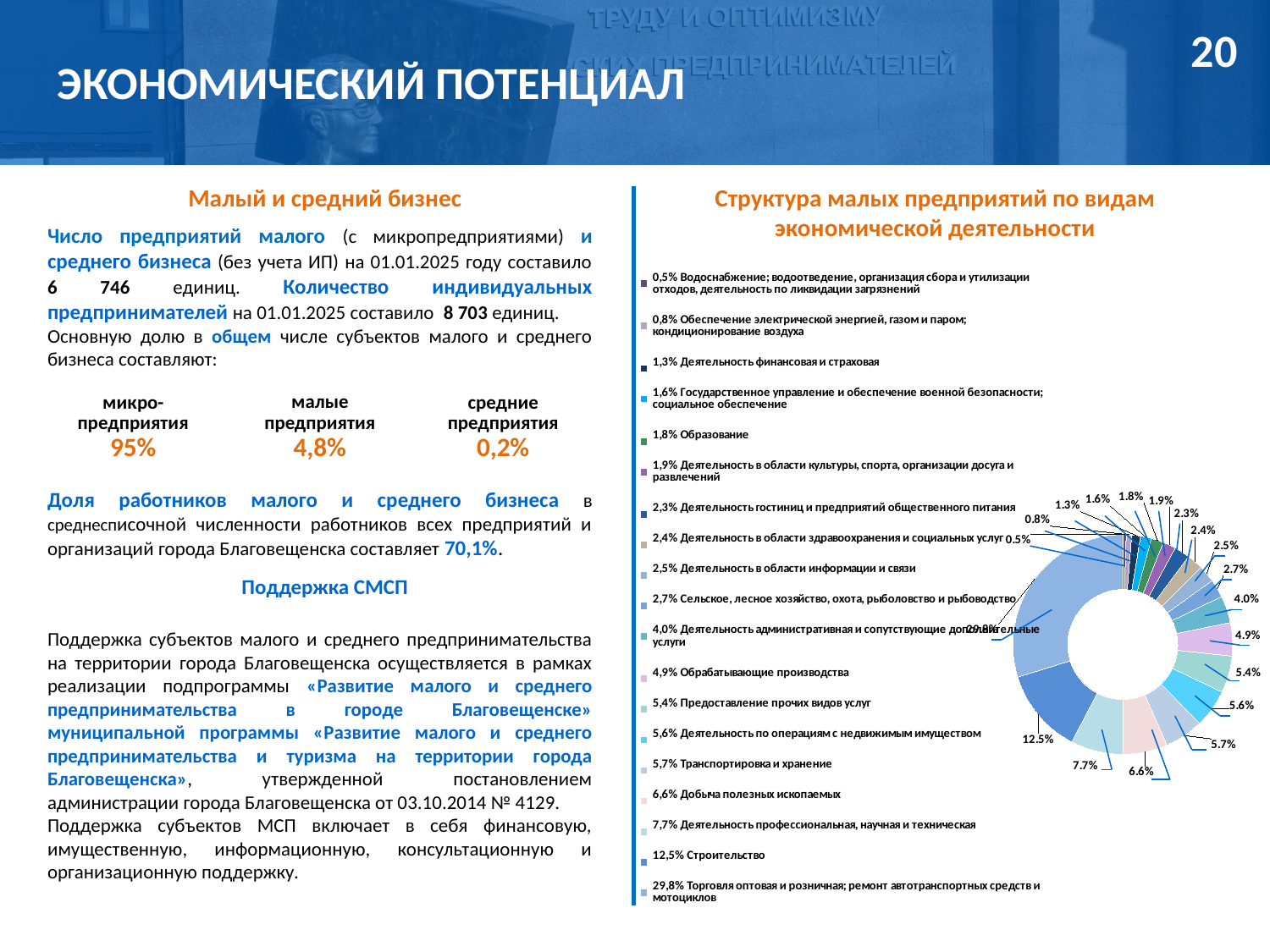
What is the title of the chart on the right side of the slide? Структура малых предприятий по видам экономической деятельности In the chart "Структура малых предприятий по видам экономической деятельности", by how many percentage points does Строительство exceed Добыча полезных ископаемых? 5,9 percentage points In the chart "Структура малых предприятий по видам экономической деятельности", which category has the smallest share? Водоснабжение; водоотведение, организация сбора и утилизации отходов, деятельность по ликвидации загрязнений In the chart "Структура малых предприятий по видам экономической деятельности", what is the share of Обрабатывающие производства? 4,9% How many categories are listed in the legend of the chart "Структура малых предприятий по видам экономической деятельности"? 19 In the chart "Структура малых предприятий по видам экономической деятельности", what share of the whole does Торговля оптовая и розничная; ремонт автотранспортных средств и мотоциклов represent? 29,8% In the chart "Структура малых предприятий по видам экономической деятельности", what is the share of Строительство? 12,5% In the chart "Структура малых предприятий по видам экономической деятельности", what is the share of Образование? 1,8% What kind of chart is shown under the title "Структура малых предприятий по видам экономической деятельности"? Doughnut (pie) chart In the chart "Структура малых предприятий по видам экономической деятельности", which category has the largest share? Торговля оптовая и розничная; ремонт автотранспортных средств и мотоциклов In the chart "Структура малых предприятий по видам экономической деятельности", which is larger: Транспортировка и хранение or Предоставление прочих видов услуг? Транспортировка и хранение In the chart "Структура малых предприятий по видам экономической деятельности", what is the share of Деятельность профессиональная, научная и техническая? 7,7%